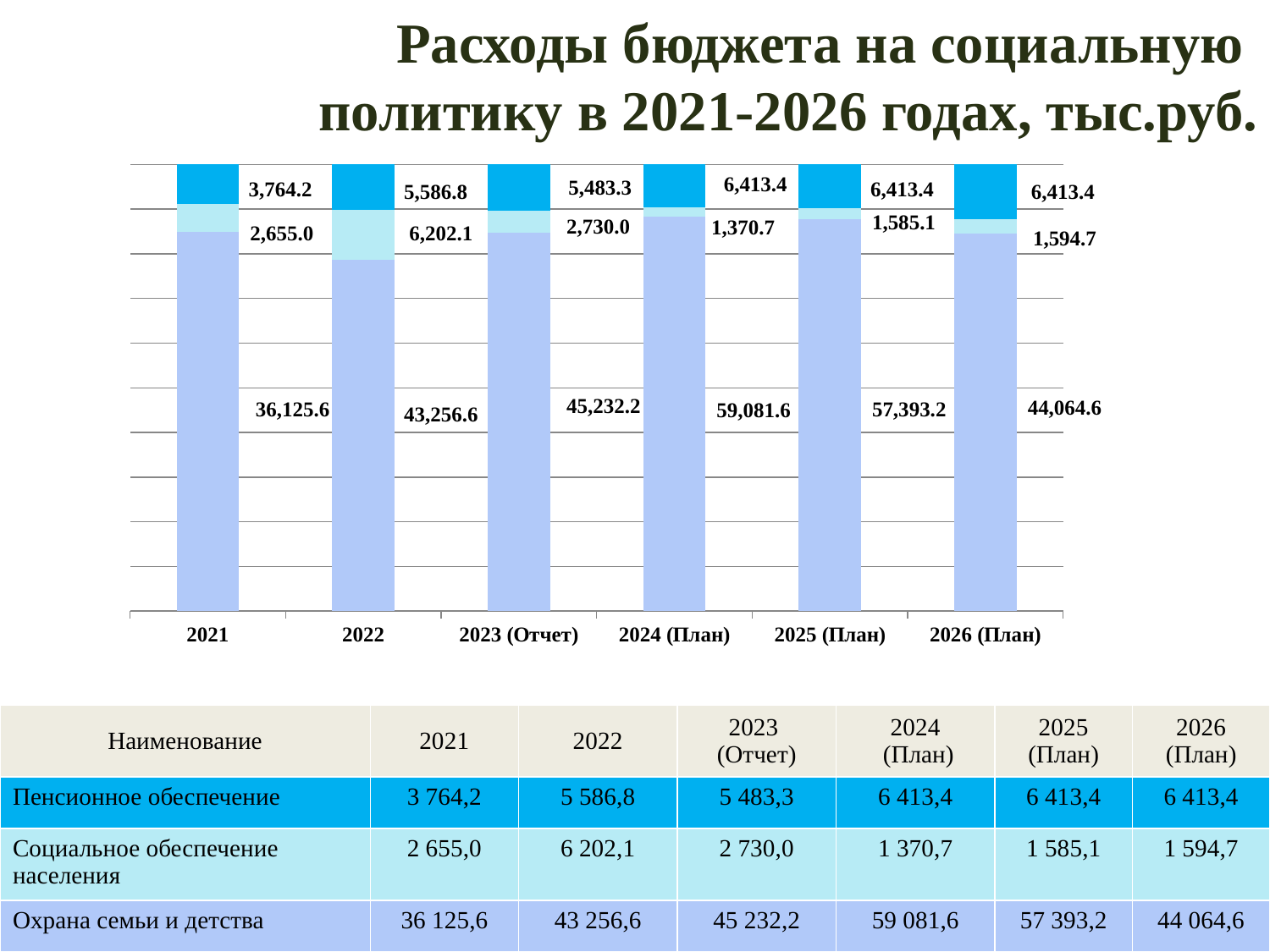
In which year is the bottom segment (Охрана семьи и детства) the lowest? 2021 In which year is the bottom segment (Охрана семьи и детства) the highest? 2024 (План) What is the difference between the bottom segment values for 2024 (План) and 2025 (План)? 1,688.4 What is the title of the chart on the slide? Расходы бюджета на социальную политику в 2021-2026 годах, тыс.руб. What is the total of the stacked bar for 2021? 42,544.8 Which is larger: the middle segment for 2022 or the middle segment for 2023 (Отчет)? 2022 What is the value of the middle segment of the bar for 2022? 6,202.1 What is the value of the top segment of the bar for 2021? 3,764.2 How many year categories are shown along the x axis of the chart? 6 What kind of chart is shown on the slide? Stacked bar chart Does the bottom segment value rise or fall from 2021 to 2024 (План)? Rise What is the value of the largest (bottom) segment of the bar for 2024 (План)? 59,081.6